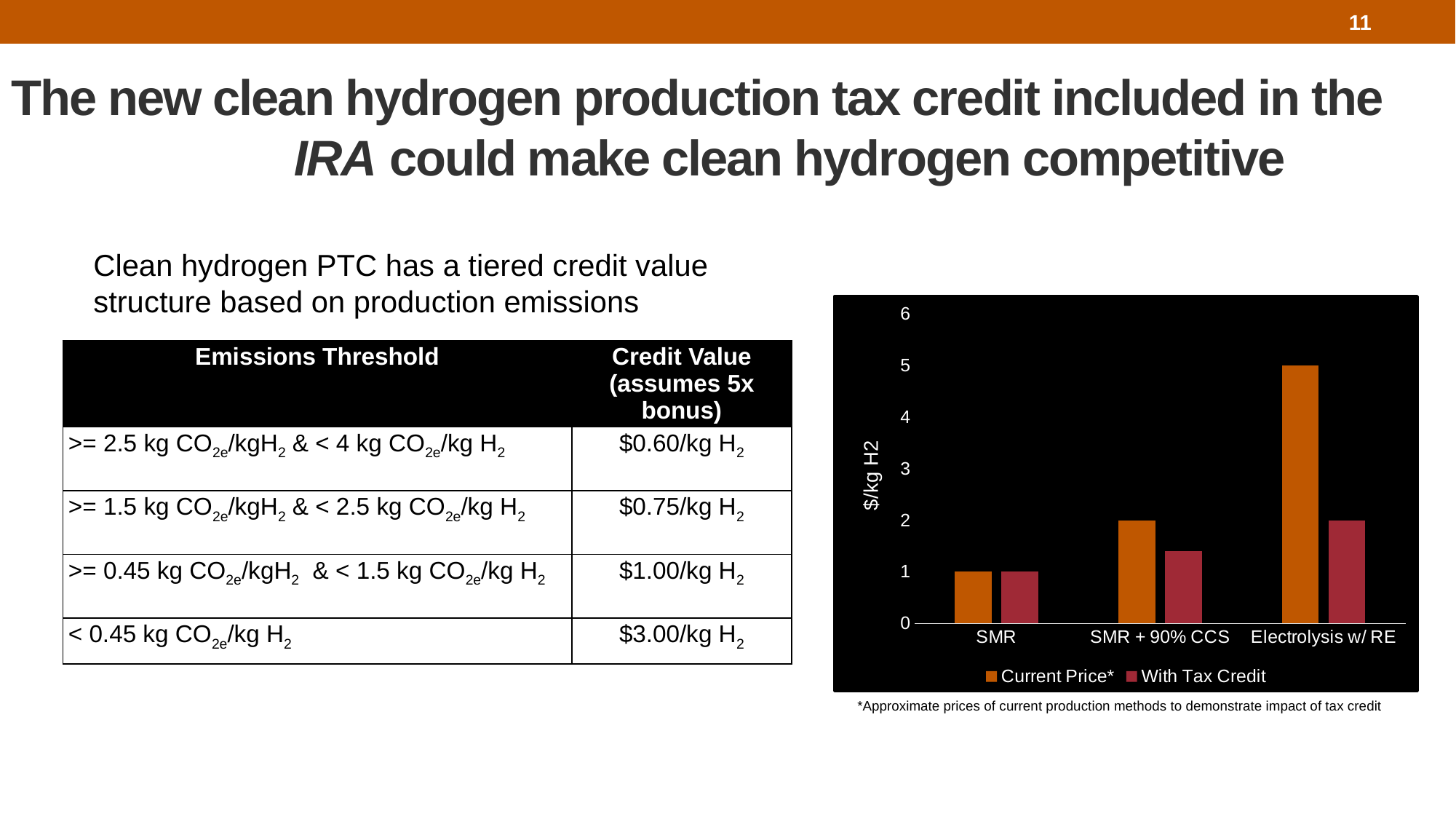
What is the label of the chart's y axis? $/kg H2 How many categories are shown on the x axis of the chart? 3 Which category has the lowest With Tax Credit bar? SMR What kind of chart is shown on the slide? bar chart Is the With Tax Credit value for SMR + 90% CCS greater or less than 1? greater Is the With Tax Credit value for Electrolysis w/ RE greater or less than 3? less What are the two series listed in the chart legend? Current Price* and With Tax Credit For Electrolysis w/ RE, which is larger: the Current Price* bar or the With Tax Credit bar? Current Price* How many series does the chart legend list? 2 What is the Current Price* value for SMR + 90% CCS? 2 Which category has the highest Current Price* bar? Electrolysis w/ RE What is the Current Price* value for Electrolysis w/ RE? 5